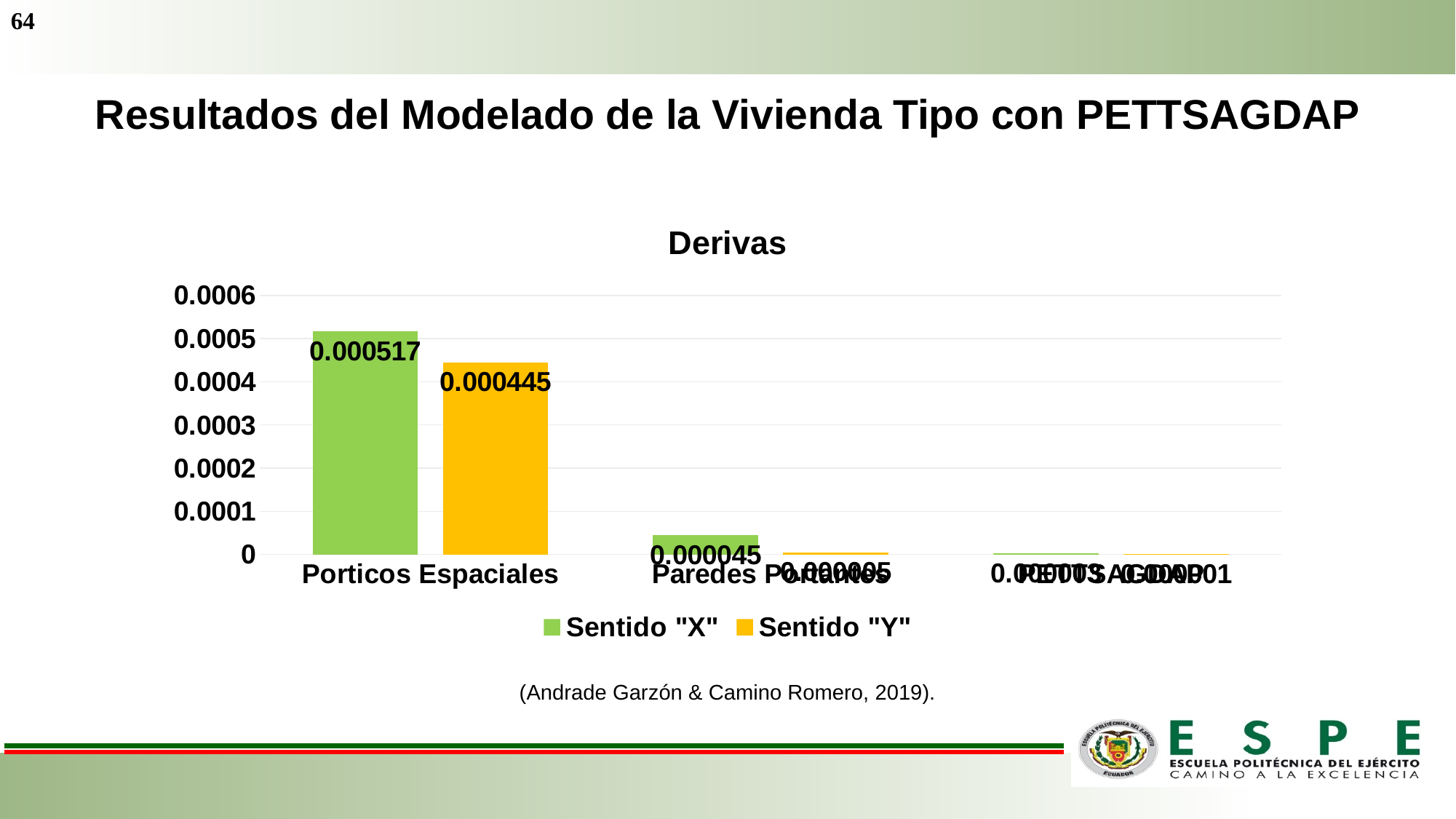
Which category has the lowest Sentido "X" value? PETTSAGDAP What is the difference between the Sentido "X" and Sentido "Y" values for Porticos Espaciales? 0.000072 Is the Sentido "Y" value for Porticos Espaciales greater or less than 0.0004? greater For Porticos Espaciales, which is larger: Sentido "X" or Sentido "Y"? Sentido "X" Is the Sentido "X" value for Paredes Portantes greater or less than 0.0001? less What kind of chart is shown? bar chart How many series does the legend list? 2 What is the value for Sentido "X" for Paredes Portantes? 0.000045 Which category has the highest Sentido "X" value? Porticos Espaciales How many categories are shown on the x axis? 3 What is the value for Sentido "X" for Porticos Espaciales? 0.000517 What is the value for Sentido "Y" for Porticos Espaciales? 0.000445